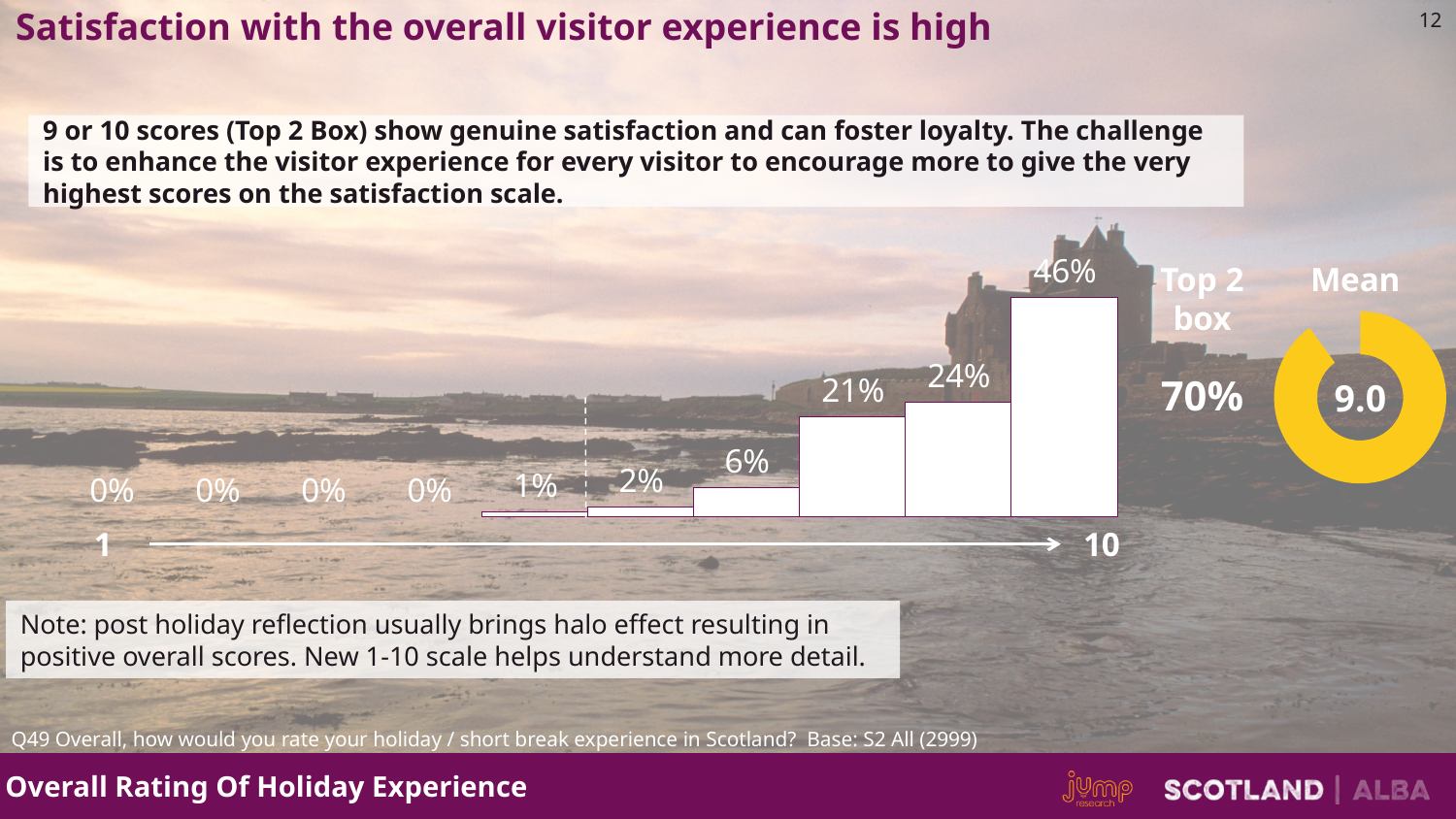
How many score categories are plotted along the x axis of the bar chart? 10 How many of the score bars show a value of 0%? 4 Do the percentages generally rise or fall as the score increases from 1 to 10? rise What percentage of visitors gave a score of 10 for their overall holiday experience? 46% What is the value shown for the bar immediately to the left of the 10 bar (score 9)? 24% Which score on the 1 to 10 scale has the highest percentage of visitors? 10 What percentage of visitors gave a score of 1 for their overall holiday experience? 0% Which is larger: the percentage for score 8 (21%) or the percentage for score 9 (24%)? score 9 (24%) What kind of chart is used to show the distribution of scores from 1 to 10? bar chart What is the Top 2 box percentage shown on the slide? 70% What mean score is shown in the donut chart? 9.0 What is the difference in percentage points between the score 10 bar (46%) and the score 9 bar (24%)? 22